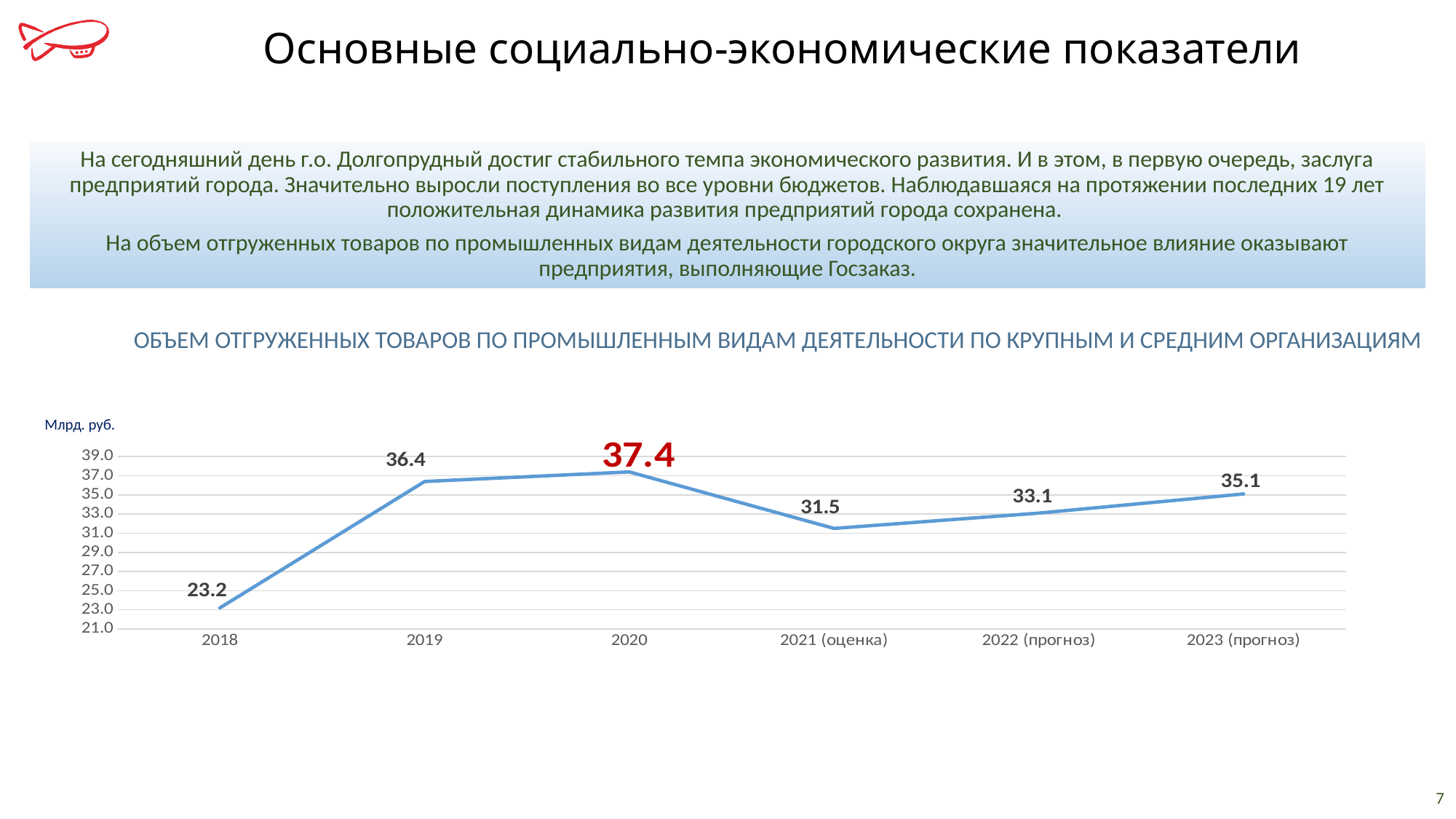
Which year has the highest value? 2020 What unit is shown on the chart's vertical axis label? Млрд. руб. What is the difference between the values for 2019 and 2018? 13.2 What kind of chart is shown on the slide? line chart What is the value for 2020? 37.4 Which year has the lowest value? 2018 Which is larger, the value for 2022 (прогноз) or the value for 2023 (прогноз)? 2023 (прогноз) What is the value for 2018? 23.2 How many data points are plotted on the chart? 6 What is the value for 2023 (прогноз)? 35.1 What is the difference between the values for 2020 and 2021 (оценка)? 5.9 What is the value for 2021 (оценка)? 31.5